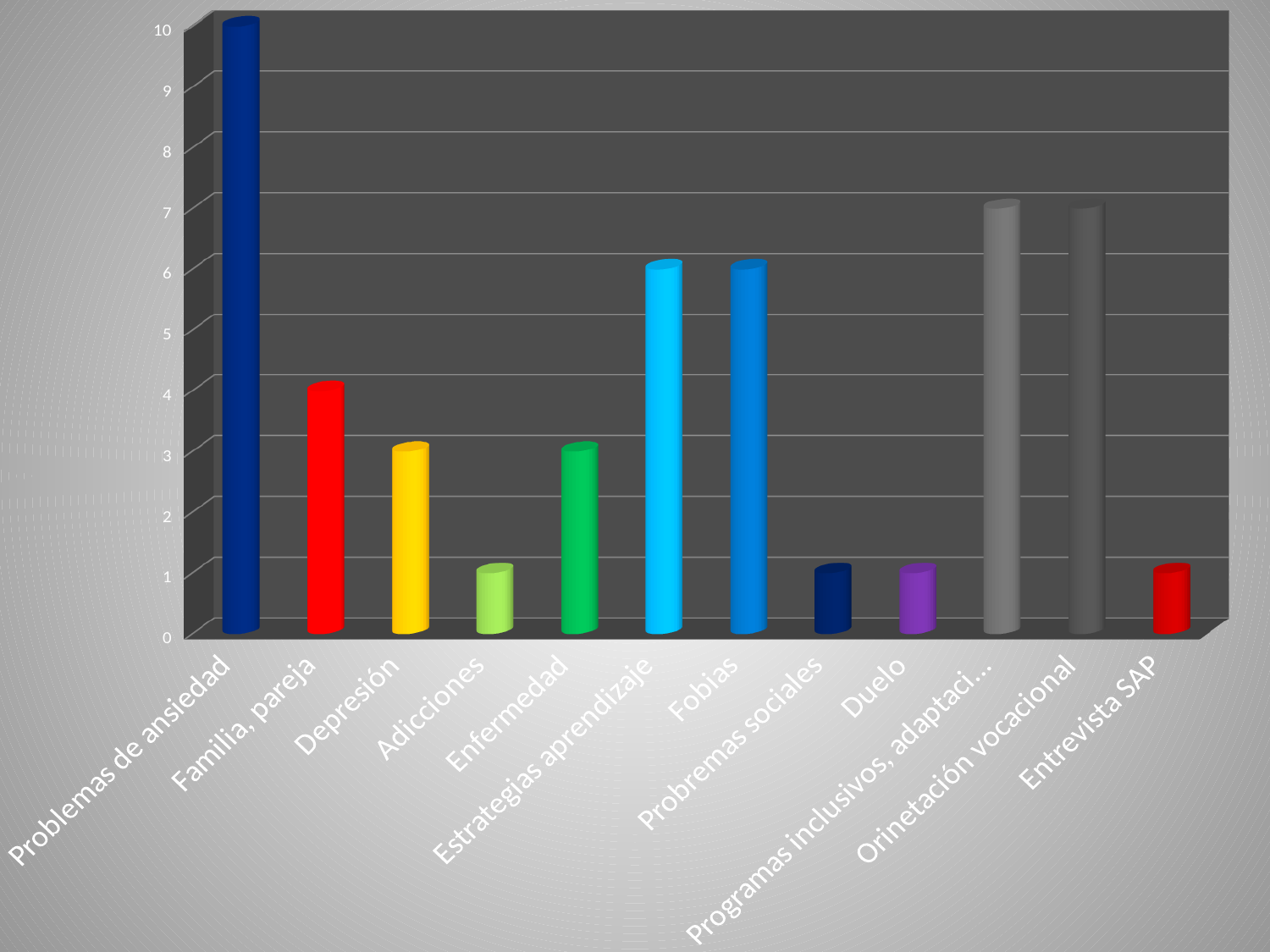
What kind of chart is shown on the slide? bar chart Which category has the highest bar in the chart? Problemas de ansiedad Is the value for Estrategias aprendizaje greater or less than 5? greater Which is larger, the value for Familia, pareja or the value for Depresión? Familia, pareja What is the value for Orinetación vocacional? 7 What is the difference between the value for Problemas de ansiedad and the value for Familia, pareja? 6 What is the value for Fobias? 6 What is the value for Familia, pareja? 4 How many categories are shown on the x axis of the chart? 12 What is the value for Problemas de ansiedad? 10 What is the highest value shown on the vertical axis of the chart? 10 Is the value for Adicciones greater or less than 2? less